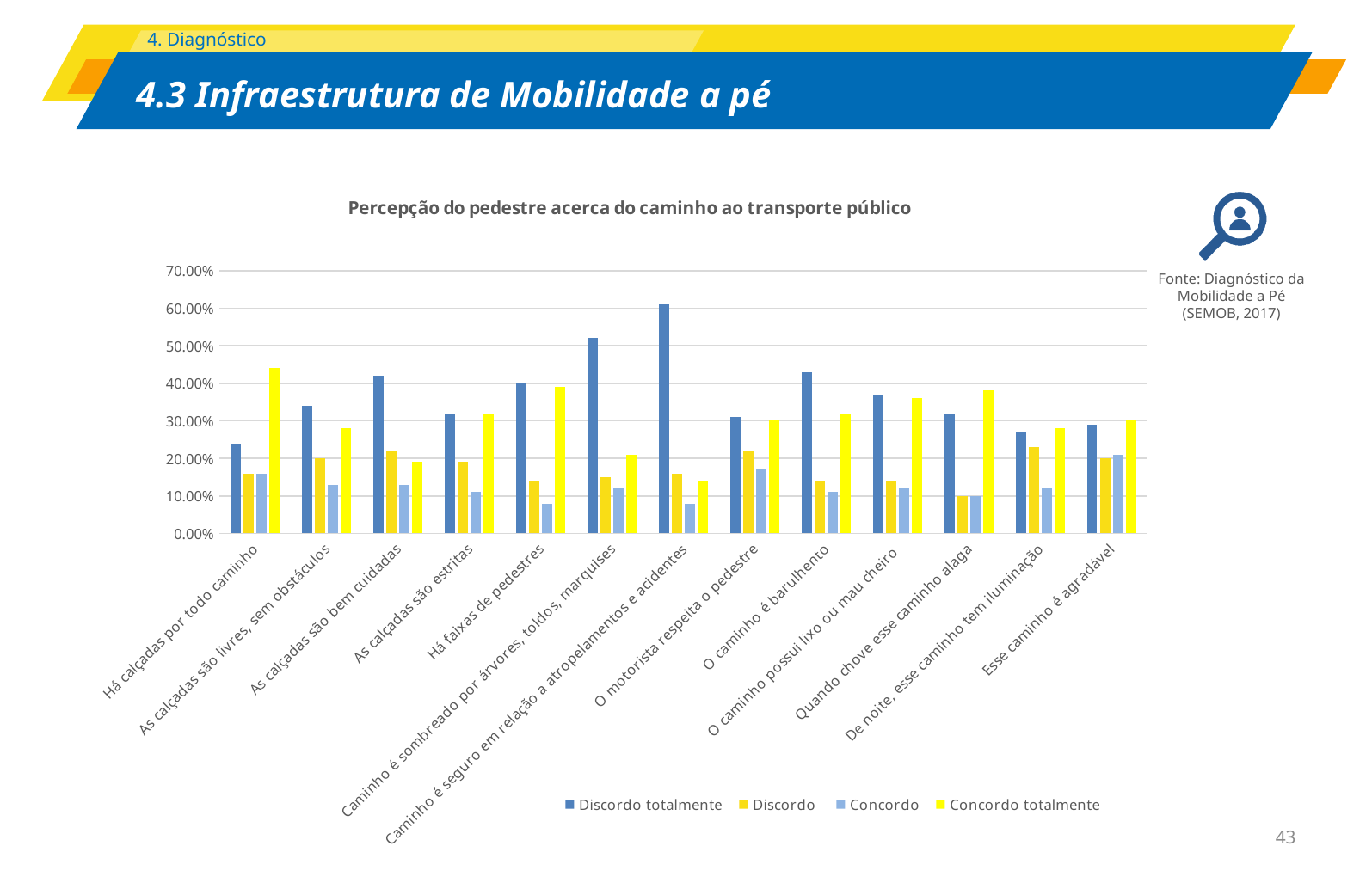
What is the title of the chart? Percepção do pedestre acerca do caminho ao transporte público What kind of chart is shown on the slide? bar chart Which category has the highest value for the 'Discordo totalmente' series? Caminho é seguro em relação a atropelamentos e acidentes Is the 'Concordo totalmente' value for 'Há calçadas por todo caminho' greater or less than 40.00%? greater Which category has the lowest value for the 'Concordo totalmente' series? Caminho é seguro em relação a atropelamentos e acidentes Is the 'Concordo' value for 'Há faixas de pedestres' greater or less than 10.00%? less For 'Há calçadas por todo caminho', which is larger: 'Discordo totalmente' or 'Concordo totalmente'? Concordo totalmente Which category has the highest value for the 'Concordo totalmente' series? Há calçadas por todo caminho How many categories are shown on the x axis? 13 How many series does the legend list? 4 Is the 'Discordo totalmente' value for 'Caminho é seguro em relação a atropelamentos e acidentes' greater or less than 50.00%? greater For 'Caminho é seguro em relação a atropelamentos e acidentes', which is larger: 'Discordo totalmente' or 'Concordo totalmente'? Discordo totalmente